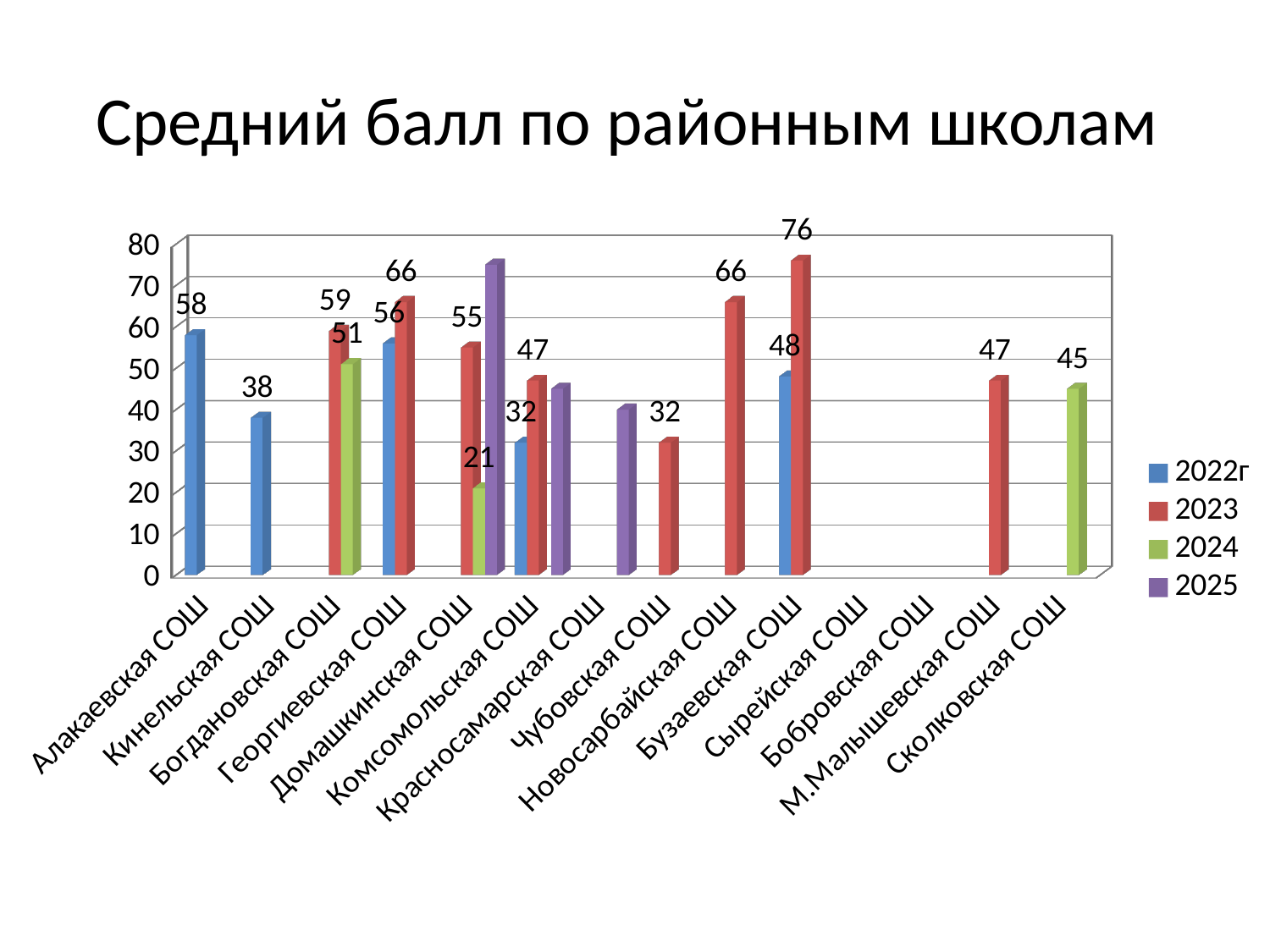
Is the 2025 value for Домашкинская СОШ greater or less than 70? greater For Богдановская СОШ, which series has the larger value, 2023 or 2024? 2023 Is the 2025 value for Красносамарская СОШ greater or less than 50? less How many series does the legend list? 4 What is the 2024 value for Домашкинская СОШ? 21 What type of chart is shown on the slide? Bar chart Which school has the highest value in the 2023 series? Бузаевская СОШ What is the 2023 value for Бузаевская СОШ? 76 Which school has the lowest labelled value on the chart? Домашкинская СОШ How many schools are listed on the x axis? 14 What is the difference between the 2023 and 2022г values for Георгиевская СОШ? 10 What is the value for Алакаевская СОШ in the 2022г series? 58